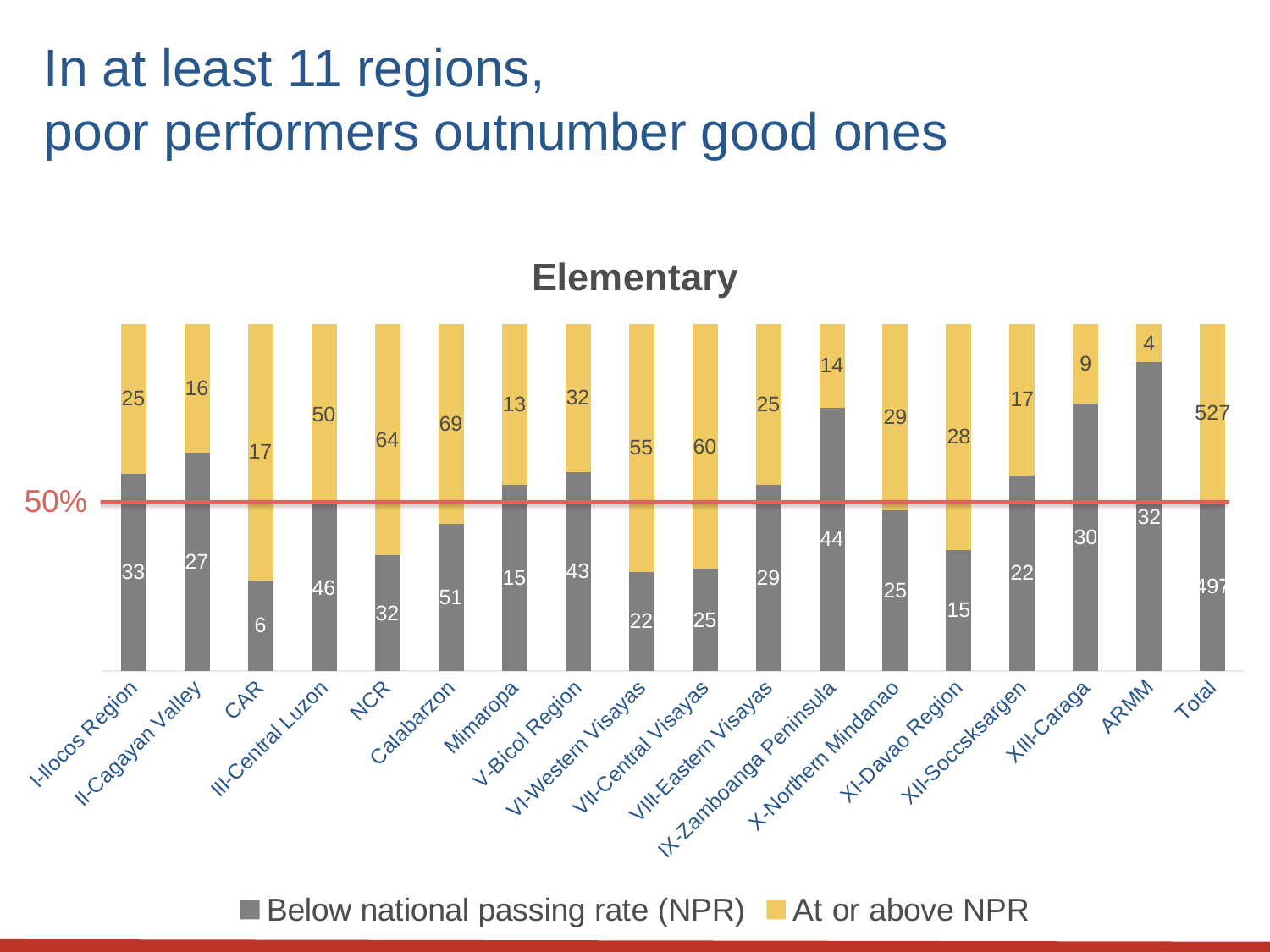
What is the value for 'Below national passing rate (NPR)' in NCR? 32 What is the 'Below national passing rate (NPR)' value for the Total bar? 497 What is the title of the chart? Elementary What is the difference between the 'At or above NPR' and 'Below national passing rate (NPR)' values for VII-Central Visayas? 35 What kind of chart is shown on the slide? Stacked bar chart How many series does the legend list? 2 Excluding the Total bar, which region has the highest 'Below national passing rate (NPR)' value? Calabarzon What is the value for 'At or above NPR' in Calabarzon? 69 In IX-Zamboanga Peninsula, which is larger: the 'Below national passing rate (NPR)' value or the 'At or above NPR' value? Below national passing rate (NPR) How many categories are shown on the x axis, including Total? 18 What is the combined total of the two values for CAR? 23 Which region has the lowest 'At or above NPR' value? ARMM